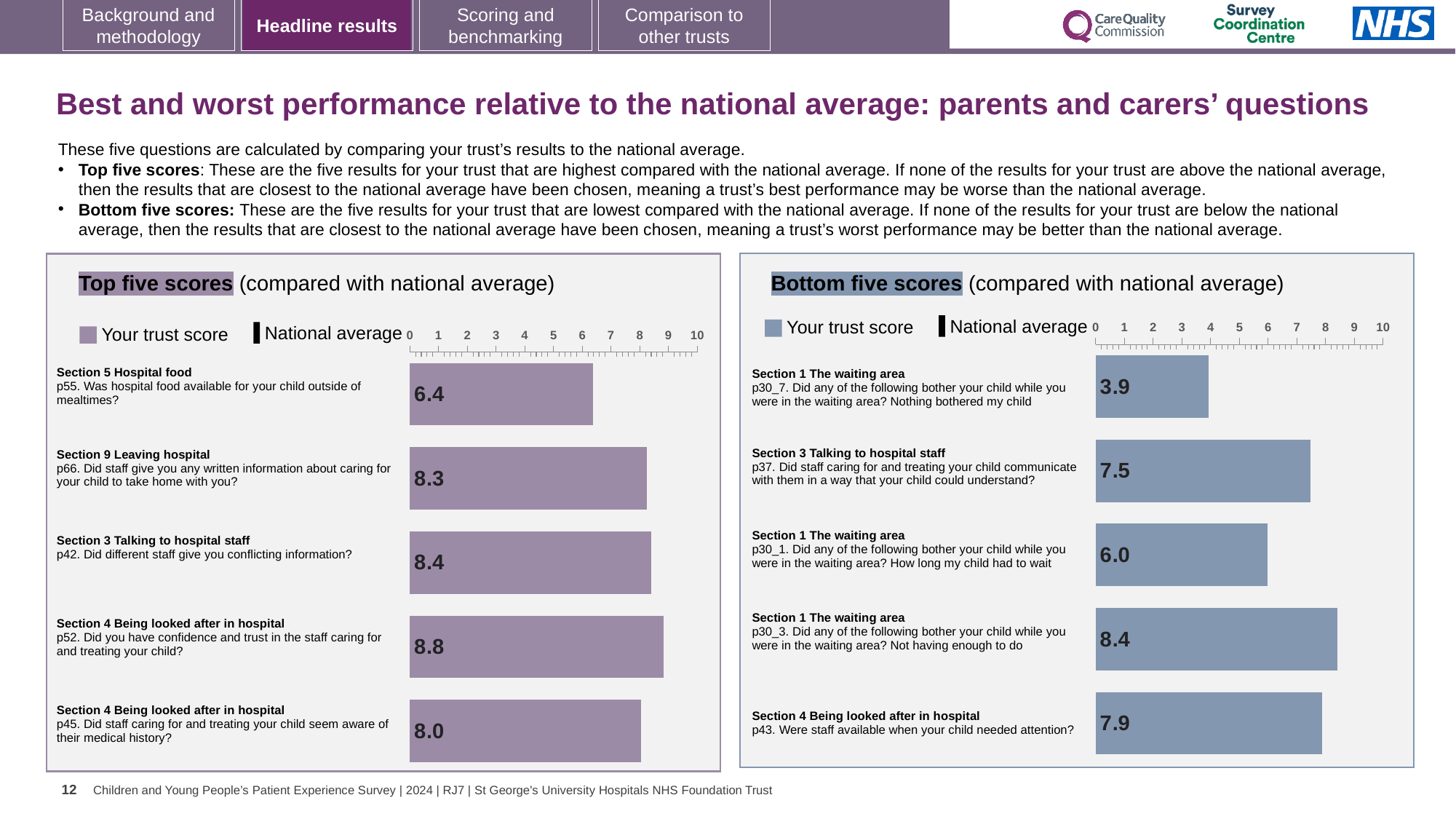
How many questions are plotted in the Bottom five scores chart? 5 How many entries does the legend of the Bottom five scores chart list? 2 In the Bottom five scores chart, which question has the lowest trust score? p30_7. Did any of the following bother your child while you were in the waiting area? Nothing bothered my child What type of chart is the Top five scores chart? bar chart In the Top five scores chart, what colour are the trust score bars? purple In the Top five scores chart, is the trust score for p66 greater or less than 5? greater In the Top five scores chart, what is the difference between the trust scores for p52 and p55? 2.4 In the Top five scores chart, which question has the highest trust score? p52. Did you have confidence and trust in the staff caring for and treating your child? In the Top five scores chart, what is the trust score for p55 (Was hospital food available for your child outside of mealtimes?)? 6.4 In the Bottom five scores chart, what is the difference between the trust scores for p30_3 and p30_7? 4.5 In the Bottom five scores chart, what is the trust score for p43 (Were staff available when your child needed attention?)? 7.9 In the Bottom five scores chart, which has the larger trust score: p37 or p30_1? p37